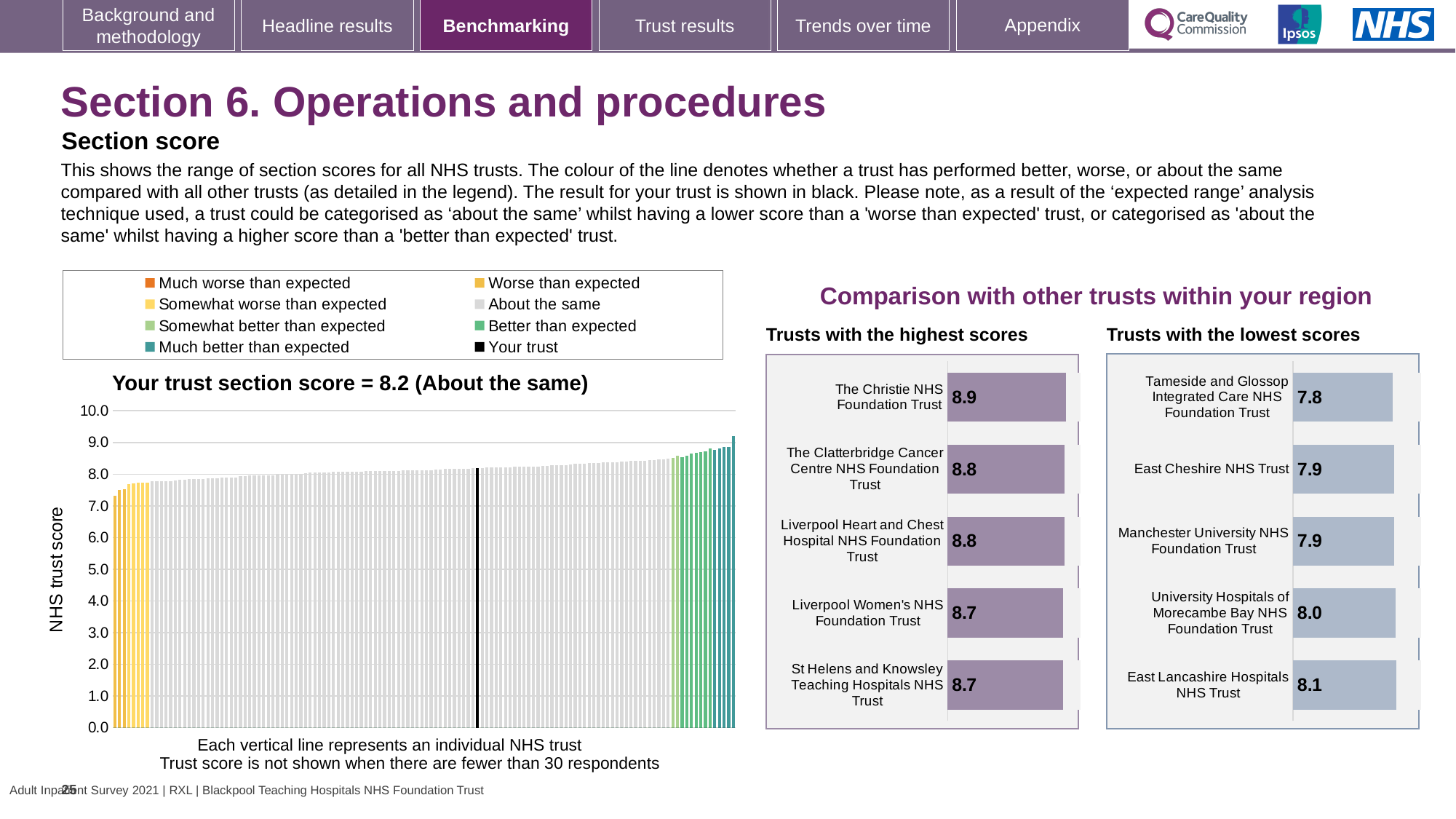
How many entries does the legend above the 'Your trust section score' chart list? 8 In the 'Trusts with the lowest scores' chart, which trust has the lowest score? Tameside and Glossop Integrated Care NHS Foundation Trust In the chart 'Your trust section score = 8.2 (About the same)', is the value of the leftmost bar greater or less than 8.0? less In the 'Trusts with the highest scores' chart, what is the score for The Christie NHS Foundation Trust? 8.9 In the chart 'Your trust section score = 8.2 (About the same)', do the bars rise or fall from left to right? rise In the 'Trusts with the highest scores' chart, what is the difference between the scores of The Christie NHS Foundation Trust and Liverpool Women's NHS Foundation Trust? 0.2 How many trusts are shown in the 'Trusts with the lowest scores' chart? 5 In the chart 'Your trust section score = 8.2 (About the same)', what is the section score for your trust? 8.2 In the 'Trusts with the highest scores' chart, which trust has the highest score? The Christie NHS Foundation Trust What kind of chart is the large chart titled 'Your trust section score = 8.2 (About the same)'? bar chart What is the label on the vertical axis of the chart 'Your trust section score = 8.2 (About the same)'? NHS trust score In the 'Trusts with the lowest scores' chart, what is the score for University Hospitals of Morecambe Bay NHS Foundation Trust? 8.0